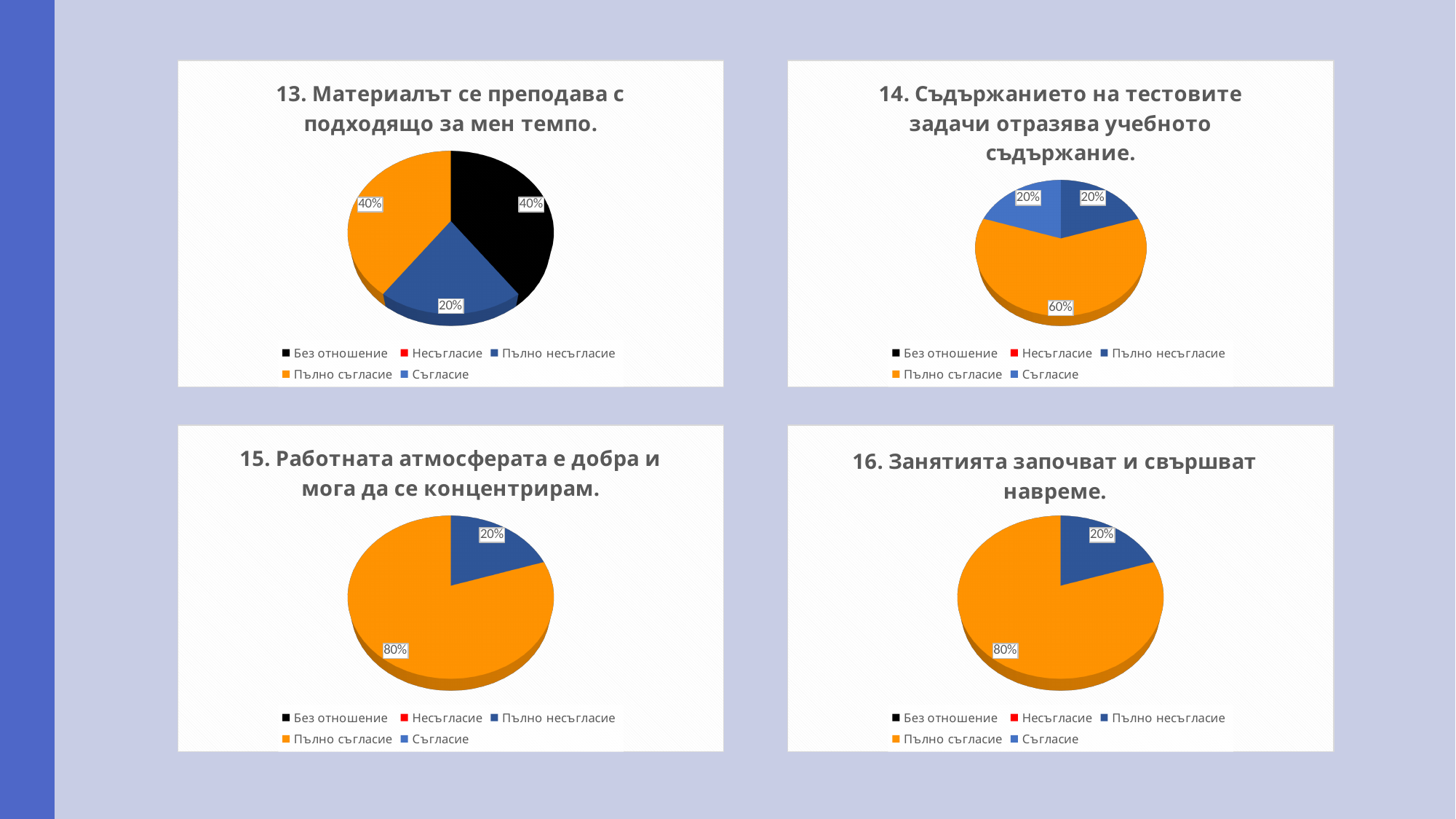
In the chart titled "15. Работната атмосферата е добра и мога да се концентрирам.", what is the difference between the orange slice (80%) and the dark blue slice (20%)? 60% In the chart titled "13. Материалът се преподава с подходящо за мен темпо.", what share is labelled on the dark blue slice (Пълно несъгласие)? 20% In the chart titled "16. Занятията започват и свършват навреме.", which is larger, the orange slice or the dark blue slice? the orange slice (Пълно съгласие) In the chart titled "13. Материалът се преподава с подходящо за мен темпо.", what share is labelled on the black slice (Без отношение)? 40% In the chart titled "14. Съдържанието на тестовите задачи отразява учебното съдържание.", how many slices does the pie have? 3 In the chart titled "16. Занятията започват и свършват навреме.", what share is labelled on the dark blue slice (Пълно несъгласие)? 20% In the chart titled "14. Съдържанието на тестовите задачи отразява учебното съдържание.", what share is labelled on the orange slice (Пълно съгласие)? 60% In the chart titled "15. Работната атмосферата е добра и мога да се концентрирам.", what share is labelled on the orange slice (Пълно съгласие)? 80% What type of chart is used in the chart titled "16. Занятията започват и свършват навреме."? pie chart How many entries does the legend list in the chart titled "13. Материалът се преподава с подходящо за мен темпо."? 5 In the chart titled "13. Материалът се преподава с подходящо за мен темпо.", what share is labelled on the orange slice (Пълно съгласие)? 40% In the chart titled "14. Съдържанието на тестовите задачи отразява учебното съдържание.", which category has the largest slice? Пълно съгласие